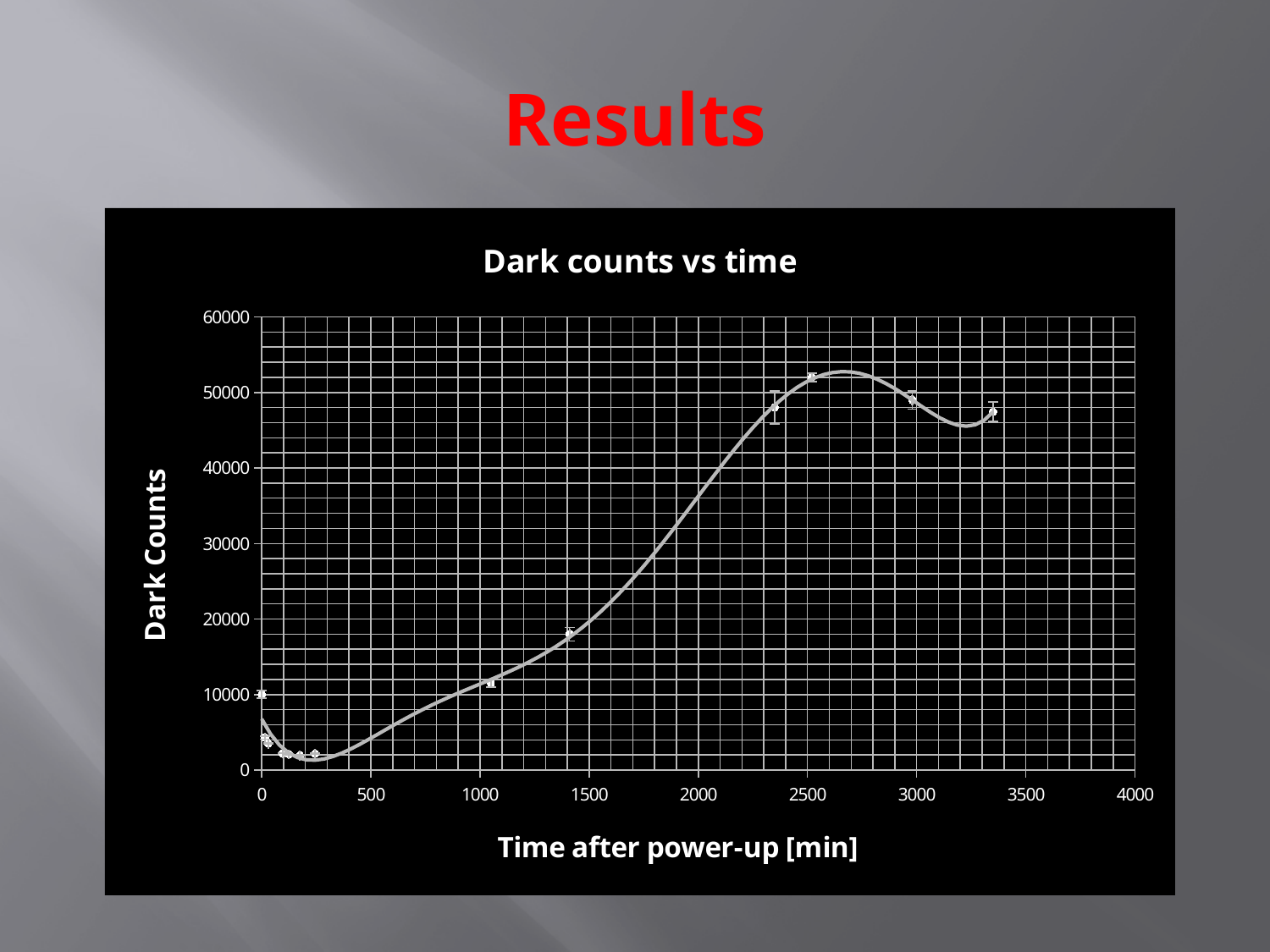
Is the dark count value at about 1400 minutes greater or less than 20000? less Is the dark count value at about 3000 minutes greater or less than 40000? greater Is the dark count at about 2500 minutes larger or smaller than the dark count at about 1400 minutes? larger Is the dark count value at about 2500 minutes greater or less than 40000? greater What is the title of the chart? Dark counts vs time What is the label of the x axis? Time after power-up [min] Do the dark counts rise or fall between 500 and 2500 minutes after power-up? rise What kind of chart is shown on the slide? Scatter chart with a smoothed line What is the maximum value shown on the y axis? 60000